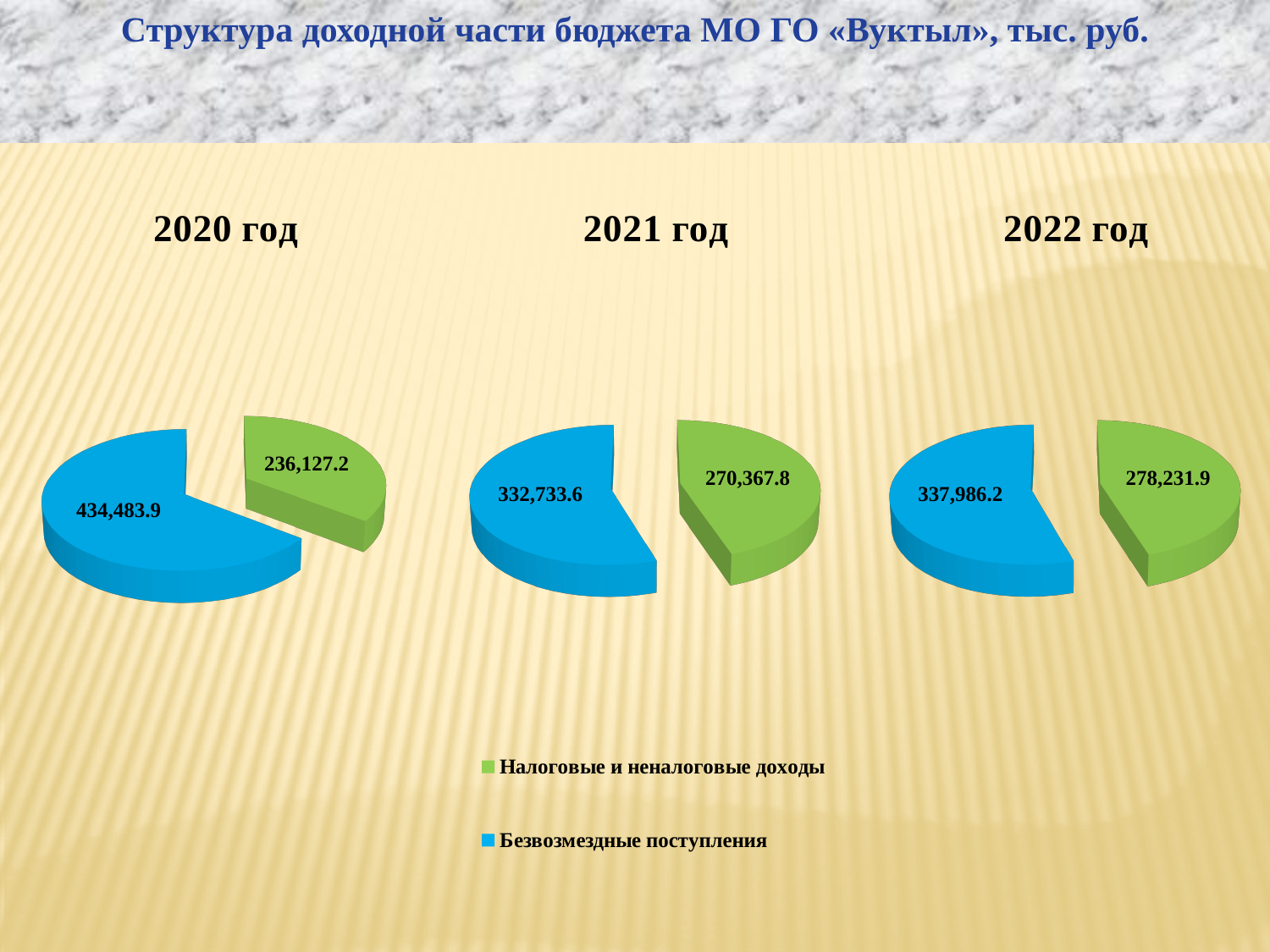
How many series does the legend list? 2 How many pie charts are on the slide? 3 In the 2020 год chart, what is the value for Налоговые и неналоговые доходы? 236,127.2 In the 2022 год chart, what is the value for Безвозмездные поступления? 337,986.2 In the 2020 год chart, what is the difference between Безвозмездные поступления and Налоговые и неналоговые доходы? 198,356.7 In the 2021 год chart, which slice is larger: Безвозмездные поступления or Налоговые и неналоговые доходы? Безвозмездные поступления In the 2020 год chart, what is the value for Безвозмездные поступления? 434,483.9 In the 2021 год chart, what is the value for Налоговые и неналоговые доходы? 270,367.8 What is the total of the two slices in the 2021 год chart? 603,101.4 Which colour represents Налоговые и неналоговые доходы in the legend? Green In the 2022 год chart, what is the difference between Безвозмездные поступления and Налоговые и неналоговые доходы? 59,754.3 What kind of charts are shown on the slide? Pie charts